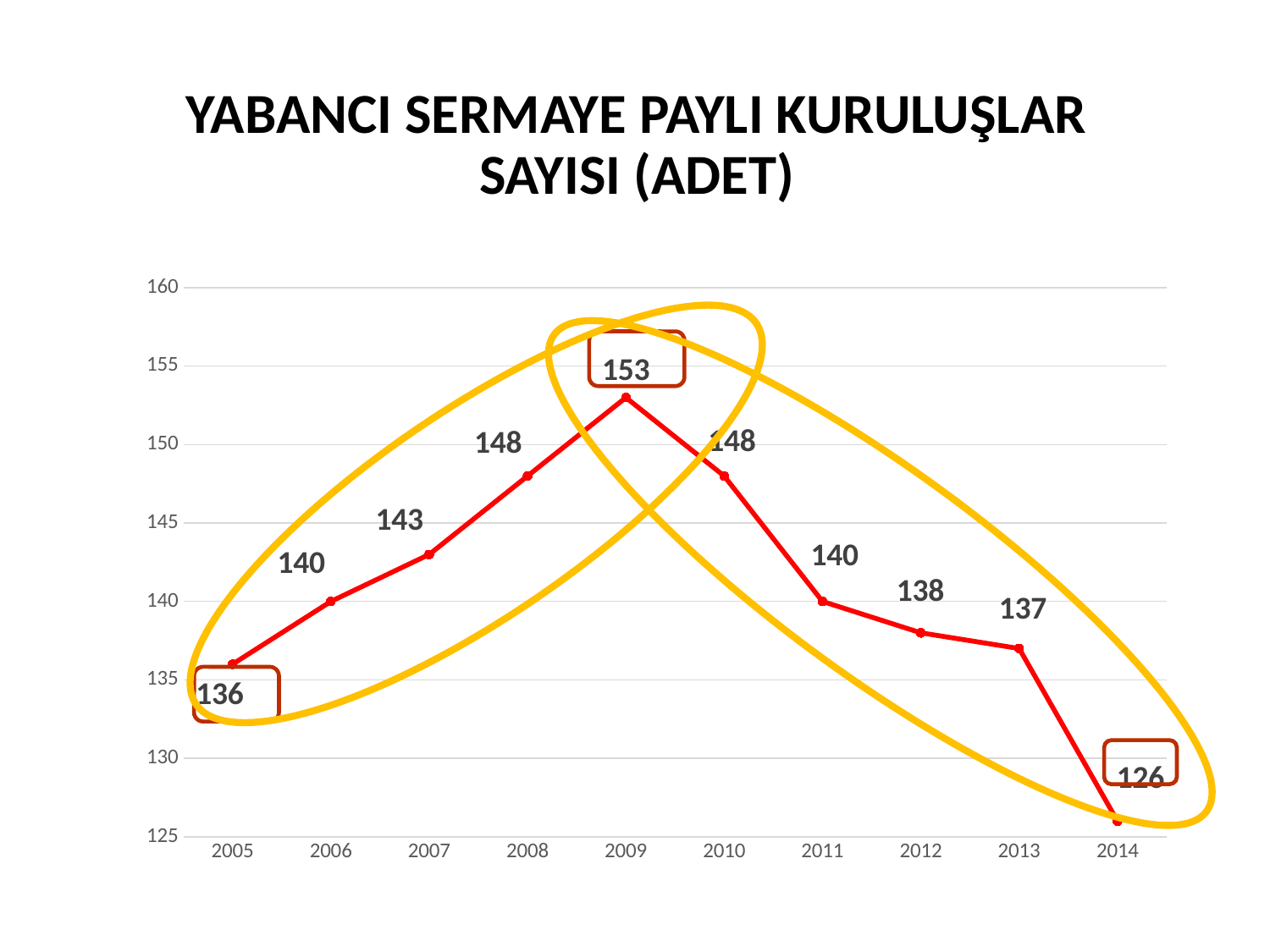
What is the value for 2014? 126 What is the value for 2012? 138 How many years are plotted on the x axis? 10 What is the value for 2005? 136 Which is larger, the value for 2007 or the value for 2011? 2007 Which year has the lowest value? 2014 Do the values rise or fall from 2009 to 2014? fall Is the value for 2013 greater or less than 140? less What is the difference between the values for 2009 and 2014? 27 What is the value for 2009? 153 What kind of chart is shown? line chart Which year has the highest value? 2009